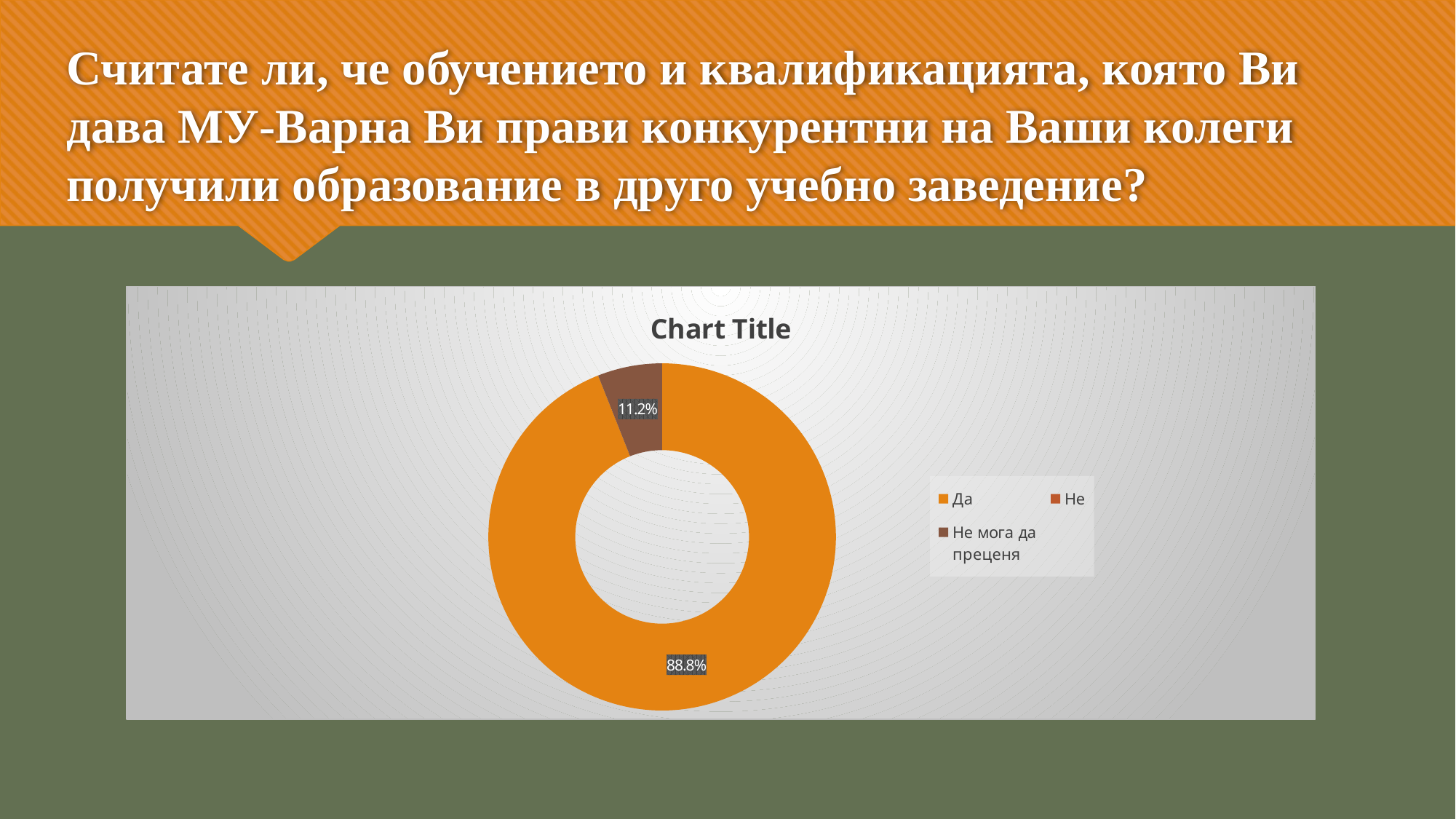
How many entries does the legend list? 3 What is the difference in percentage points between the "Да" slice and the "Не мога да преценя" slice? 77.6 percentage points Is the value for "Да" greater or less than 50%? greater What percentage is shown for the "Да" slice? 88.8% What kind of chart is shown on the slide? Doughnut chart How many data labels are printed on the chart? 2 Which of the two labelled slices is the smaller one? Не мога да преценя What percentage is shown for the "Не мога да преценя" slice? 11.2% Which category has the largest slice of the doughnut? Да Which is larger, the "Да" slice or the "Не мога да преценя" slice? Да What is the title printed above the chart? Chart Title What colour represents the "Да" category in the chart? Orange